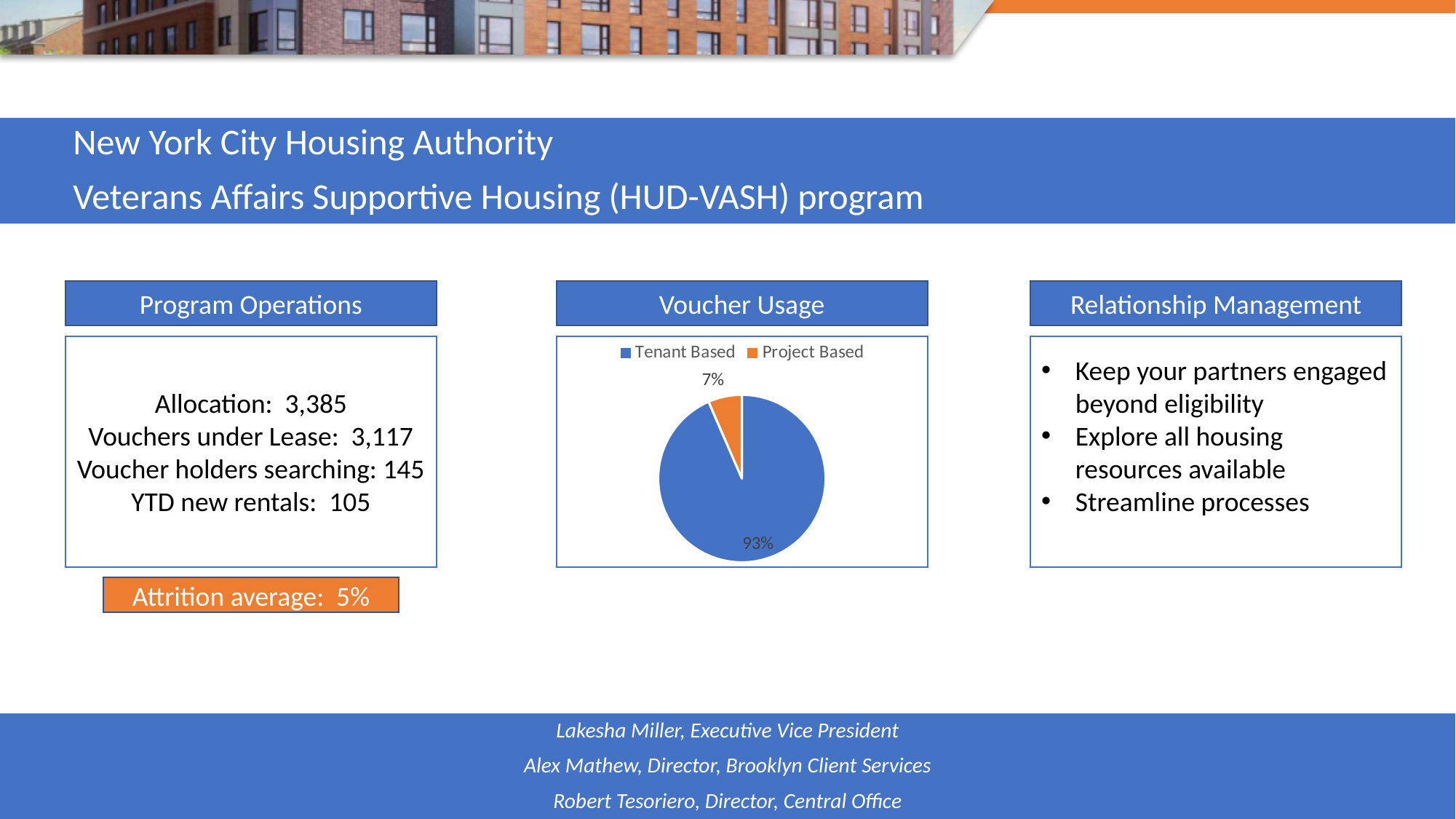
How many slices does the Voucher Usage pie chart have? 2 Which slice of the Voucher Usage pie is the largest? Tenant Based What share of the Voucher Usage pie is Tenant Based? 93% What colour is the Project Based slice in the Voucher Usage pie chart? orange What colour is the Tenant Based slice in the Voucher Usage pie chart? blue What kind of chart is shown under the Voucher Usage heading? pie chart How many entries does the legend of the Voucher Usage pie chart list? 2 Which slice of the Voucher Usage pie is the smallest? Project Based What is the difference in percentage points between the Tenant Based and Project Based slices of the Voucher Usage pie? 86 In the Voucher Usage pie, which is larger: Tenant Based or Project Based? Tenant Based What share of the Voucher Usage pie is Project Based? 7%